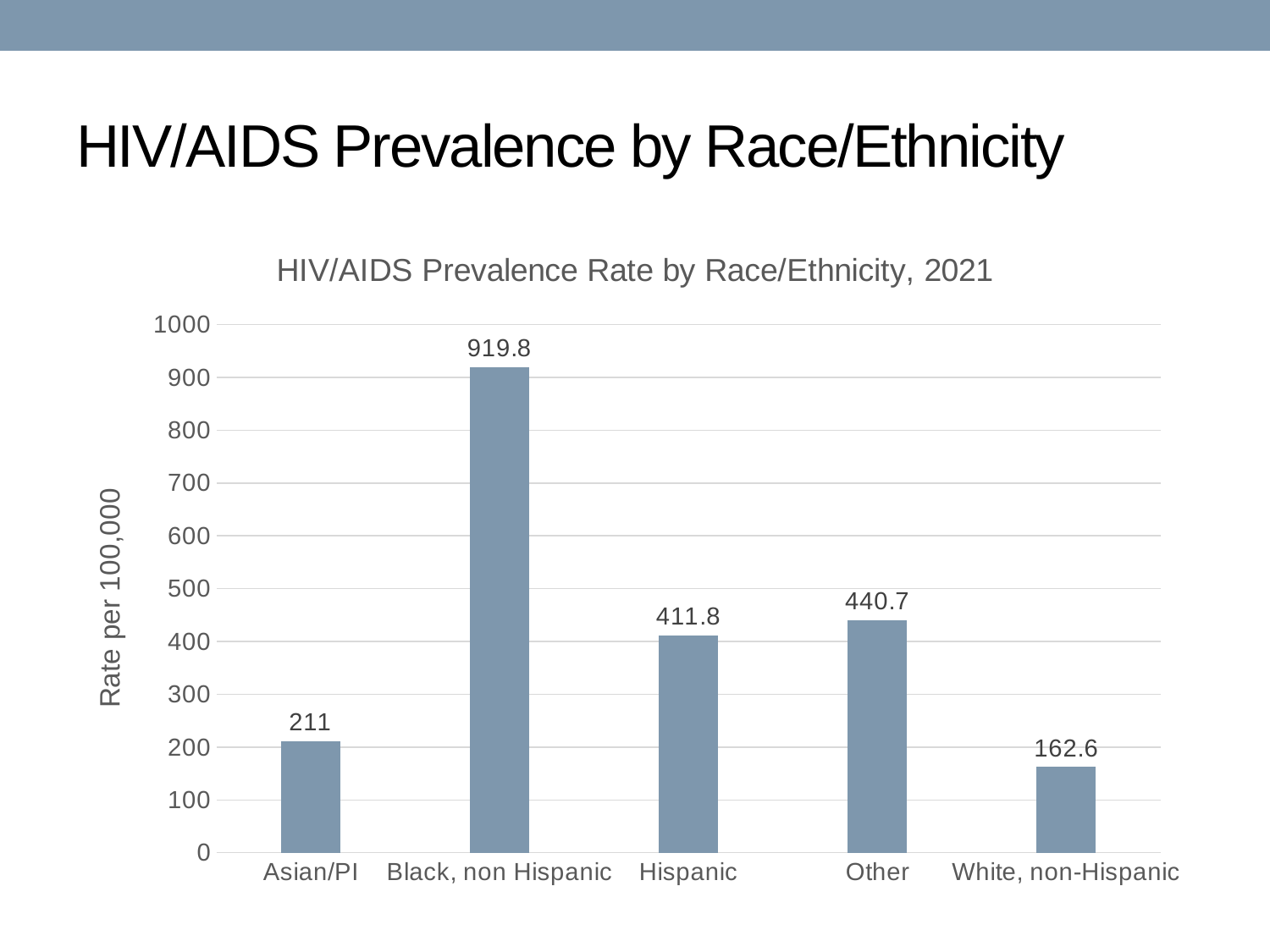
Which race/ethnicity has the highest HIV/AIDS prevalence rate? Black, non Hispanic Is the value for Asian/PI greater or less than 300? less What kind of chart is shown on the slide? Bar chart What is the HIV/AIDS prevalence rate for White, non-Hispanic? 162.6 What is the difference between the prevalence rates for Other and Hispanic? 28.9 Which has a higher prevalence rate, Other or Hispanic? Other What is the label of the vertical axis? Rate per 100,000 What is the HIV/AIDS prevalence rate for Black, non Hispanic? 919.8 What is the HIV/AIDS prevalence rate for Hispanic? 411.8 How many race/ethnicity categories are shown in the chart? 5 What is the HIV/AIDS prevalence rate for Asian/PI? 211 Which race/ethnicity has the lowest HIV/AIDS prevalence rate? White, non-Hispanic